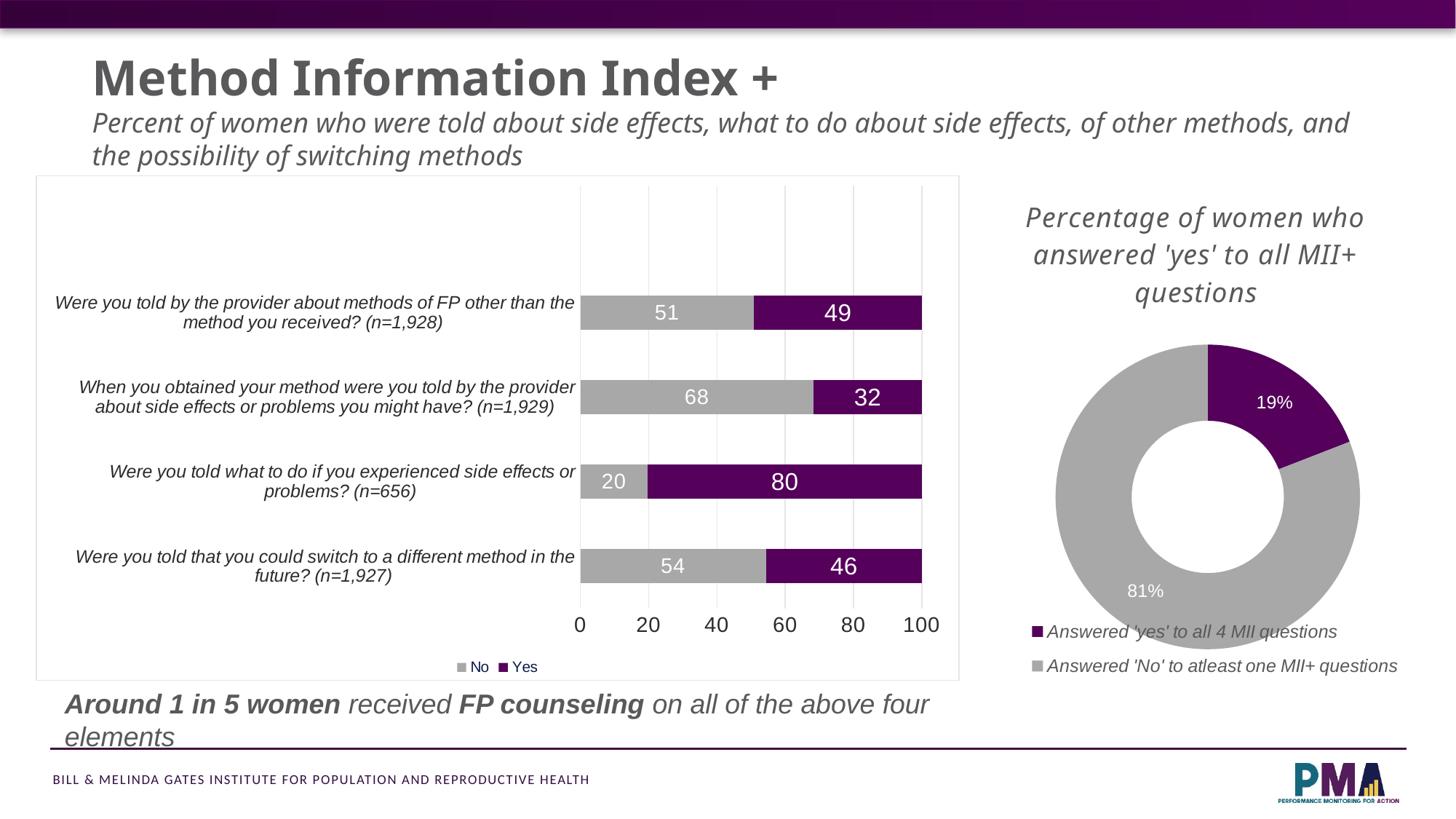
In the stacked bar chart on the left, what is the total of the 'No' and 'Yes' values for 'Were you told what to do if you experienced side effects or problems? (n=656)'? 100 In the stacked bar chart on the left, which question has the lowest 'Yes' value? When you obtained your method were you told by the provider about side effects or problems you might have? (n=1,929) In the doughnut chart on the right, what share of women answered 'yes' to all 4 MII questions? 19% In the stacked bar chart on the left, what is the 'No' value for 'When you obtained your method were you told by the provider about side effects or problems you might have? (n=1,929)'? 68 In the doughnut chart on the right, what colour is the slice for 'Answered 'No' to atleast one MII+ questions'? Grey What kind of chart is the chart on the right titled 'Percentage of women who answered 'yes' to all MII+ questions'? Doughnut chart In the stacked bar chart on the left, which question has the highest 'Yes' value? Were you told what to do if you experienced side effects or problems? (n=656) In the stacked bar chart on the left, what is the 'Yes' value for 'Were you told what to do if you experienced side effects or problems? (n=656)'? 80 In the stacked bar chart on the left, is the 'Yes' value larger for 'Were you told by the provider about methods of FP other than the method you received? (n=1,928)' or for 'Were you told that you could switch to a different method in the future? (n=1,927)'? Were you told by the provider about methods of FP other than the method you received? (n=1,928) In the stacked bar chart on the left, what is the difference between the 'No' and 'Yes' values for 'Were you told that you could switch to a different method in the future? (n=1,927)'? 8 How many questions (categories) are shown in the stacked bar chart on the left? 4 How many series does the legend of the stacked bar chart on the left list? 2